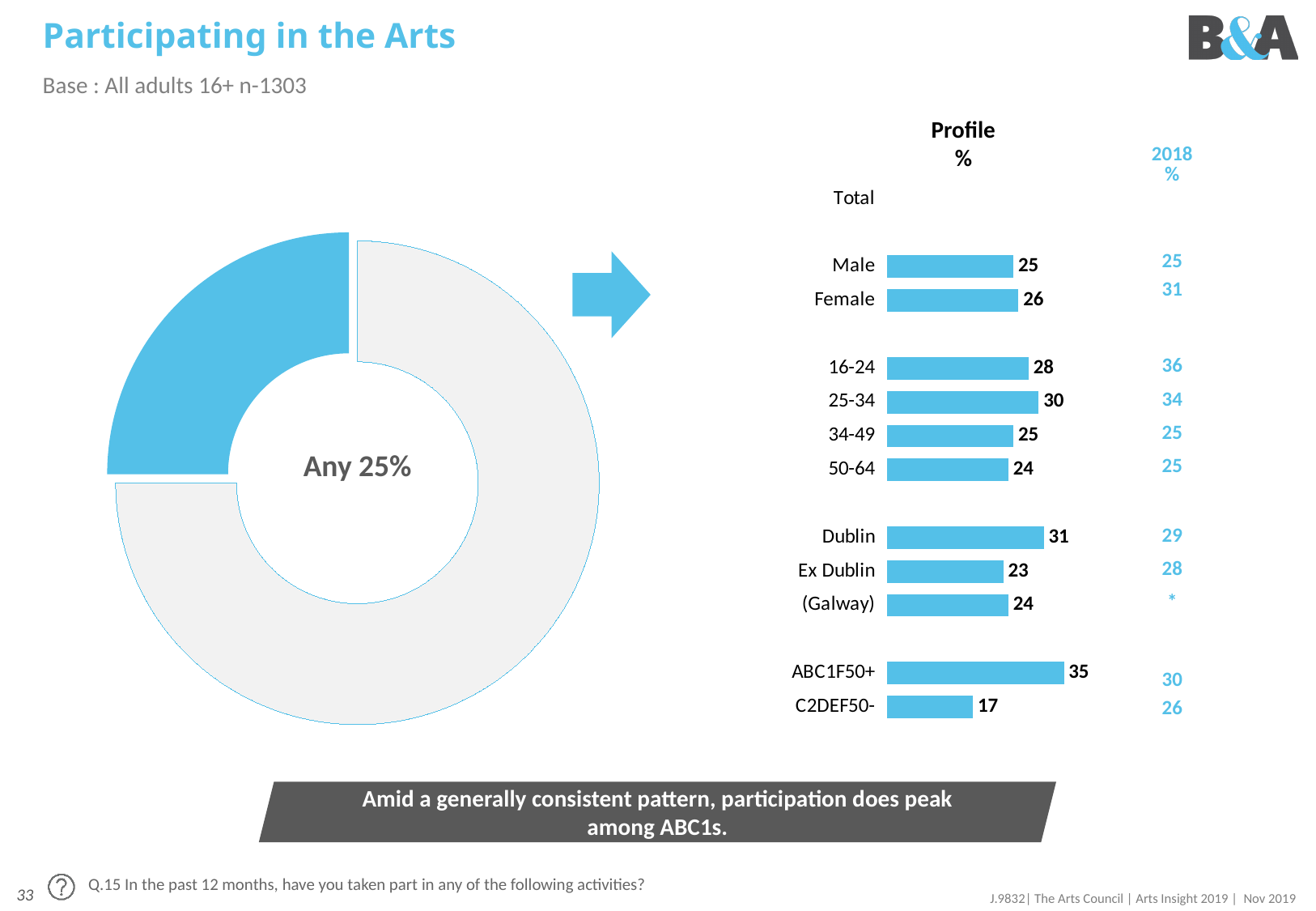
How many bars are shown on the bar chart? 11 On the bar chart, what is the difference between the Profile % values for ABC1F50+ and C2DEF50-? 18 On the bar chart, what is the Profile % value for Dublin? 31 On the bar chart, what is the Profile % value for 25-34? 30 On the bar chart, which category has the lowest Profile % value? C2DEF50- On the bar chart, what is the difference between the Profile % values for 16-24 and 50-64? 4 On the bar chart, which category has the highest Profile % value? ABC1F50+ On the bar chart, which has a higher Profile % value, Dublin or Ex Dublin? Dublin On the bar chart, what is the 2018 % value shown for 16-24? 36 What percentage is shown in the centre of the donut chart? Any 25% On the bar chart, what is the Profile % value for C2DEF50-? 17 What kind of chart is shown on the left side of the slide? Donut chart